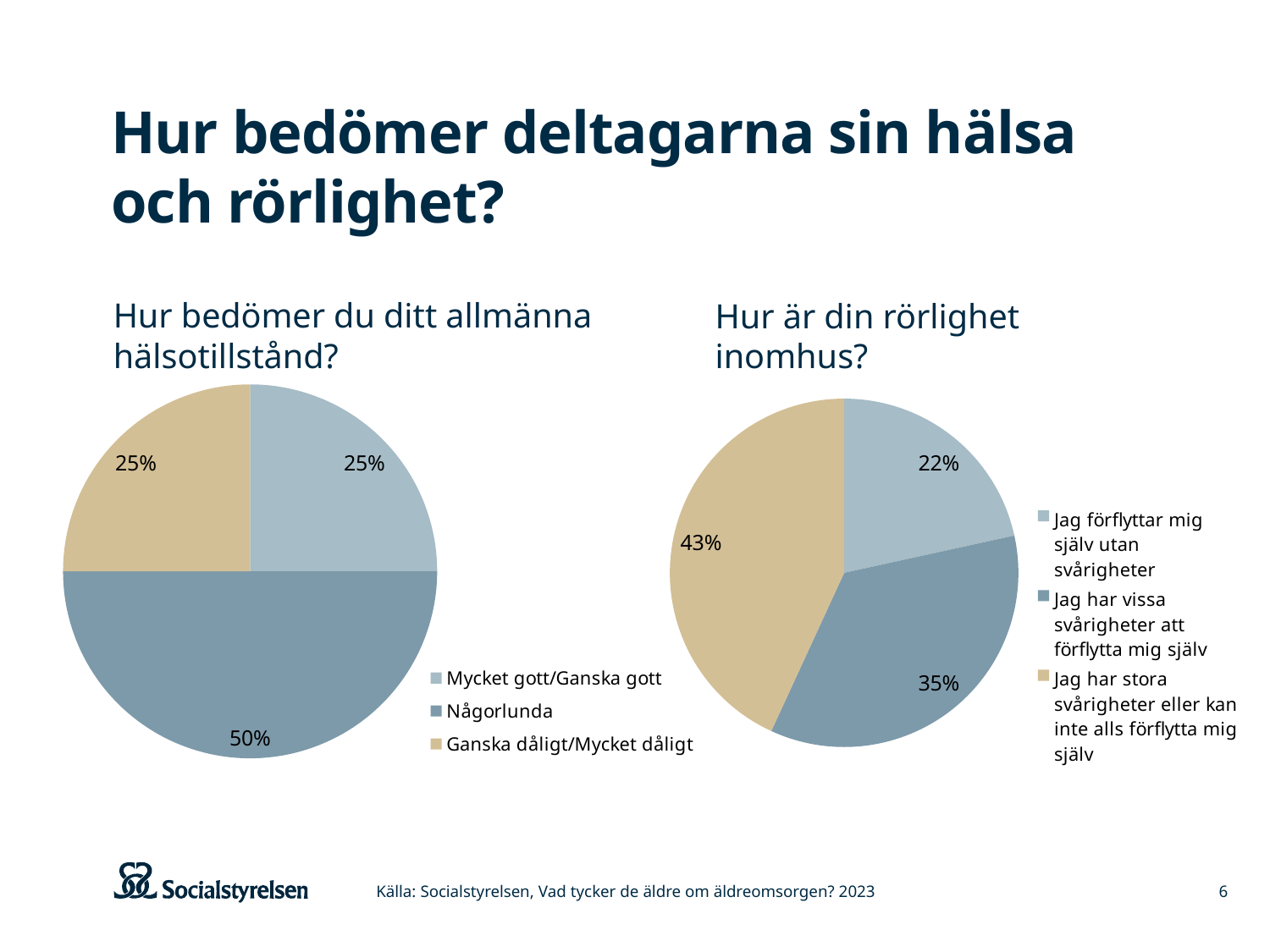
In the chart "Hur är din rörlighet inomhus?", what share of respondents answered "Jag förflyttar mig själv utan svårigheter"? 22% In the chart "Hur är din rörlighet inomhus?", which is larger: the share for "Jag har vissa svårigheter att förflytta mig själv" or the share for "Jag förflyttar mig själv utan svårigheter"? Jag har vissa svårigheter att förflytta mig själv In the chart "Hur bedömer du ditt allmänna hälsotillstånd?", what is the difference between the share for "Någorlunda" and the share for "Ganska dåligt/Mycket dåligt"? 25 percentage points In the chart "Hur bedömer du ditt allmänna hälsotillstånd?", which category has the largest share? Någorlunda In the chart "Hur är din rörlighet inomhus?", which category has the smallest share? Jag förflyttar mig själv utan svårigheter In the chart "Hur är din rörlighet inomhus?", what share of respondents answered "Jag har vissa svårigheter att förflytta mig själv"? 35% In the chart "Hur bedömer du ditt allmänna hälsotillstånd?", how many categories does the legend list? 3 In the chart "Hur bedömer du ditt allmänna hälsotillstånd?", what share of respondents answered "Mycket gott/Ganska gott"? 25% In the chart "Hur är din rörlighet inomhus?", what is the difference between the largest and smallest shares? 21 percentage points In the chart "Hur bedömer du ditt allmänna hälsotillstånd?", what share of respondents answered "Någorlunda"? 50% What type of chart is used for "Hur är din rörlighet inomhus?"? Pie chart In the chart "Hur är din rörlighet inomhus?", which category has the largest share? Jag har stora svårigheter eller kan inte alls förflytta mig själv